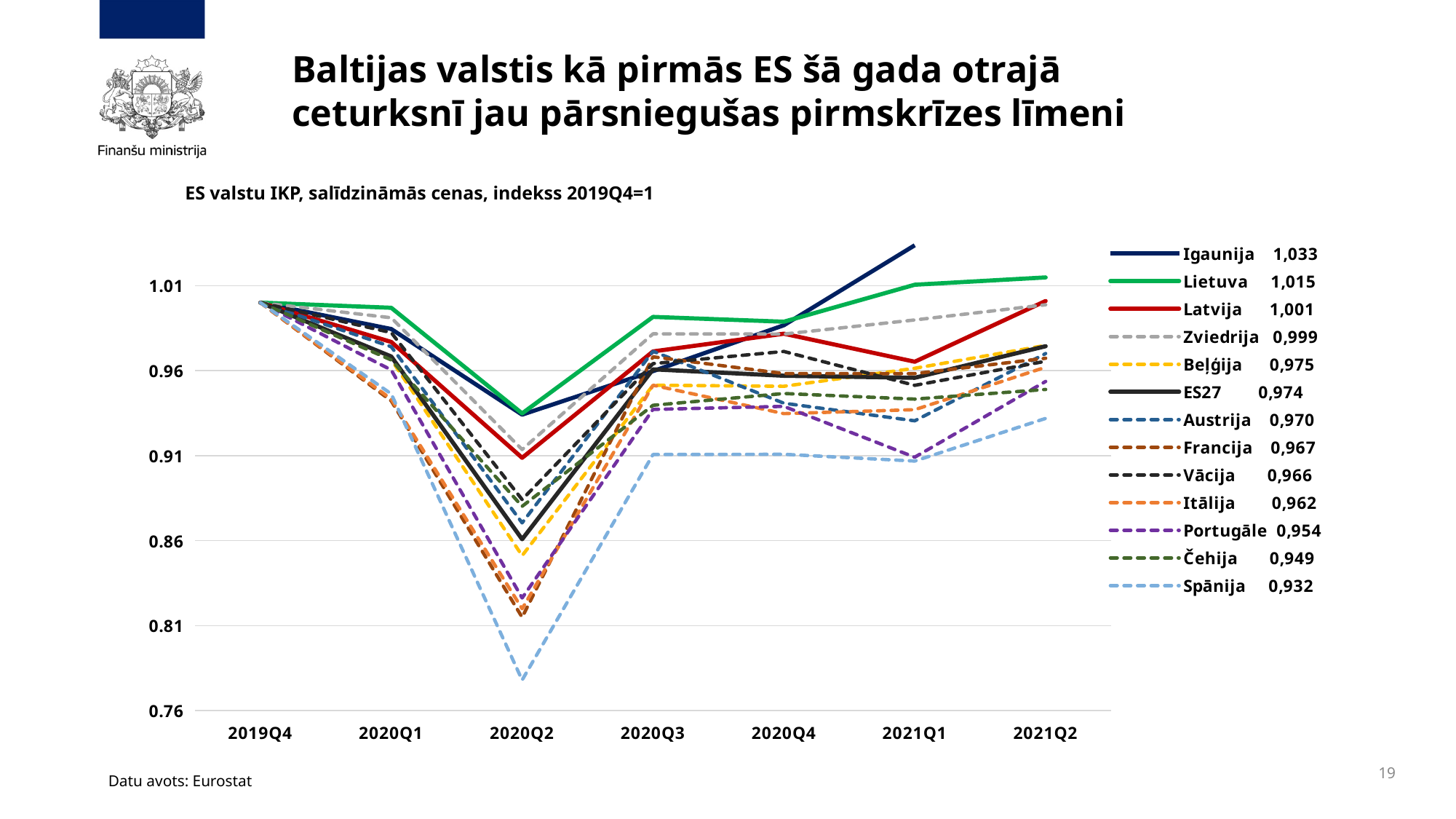
Is the value for Spānija in 2020Q2 greater or less than 0.81? less What value is shown in the legend for ES27? 0,974 How many quarters are shown on the x axis? 7 Which country has the lowest value in the legend? Spānija Which country has the highest value in the legend? Igaunija What is the title of the chart? ES valstu IKP, salīdzināmās cenas, indekss 2019Q4=1 What is the difference between the legend values for Igaunija and Lietuva? 0,018 What value is shown in the legend for Lietuva? 1,015 Which has the larger legend value, Latvija or Zviedrija? Latvija What kind of chart is shown on the slide? line chart How many series does the legend list? 13 What value is shown in the legend for Spānija? 0,932